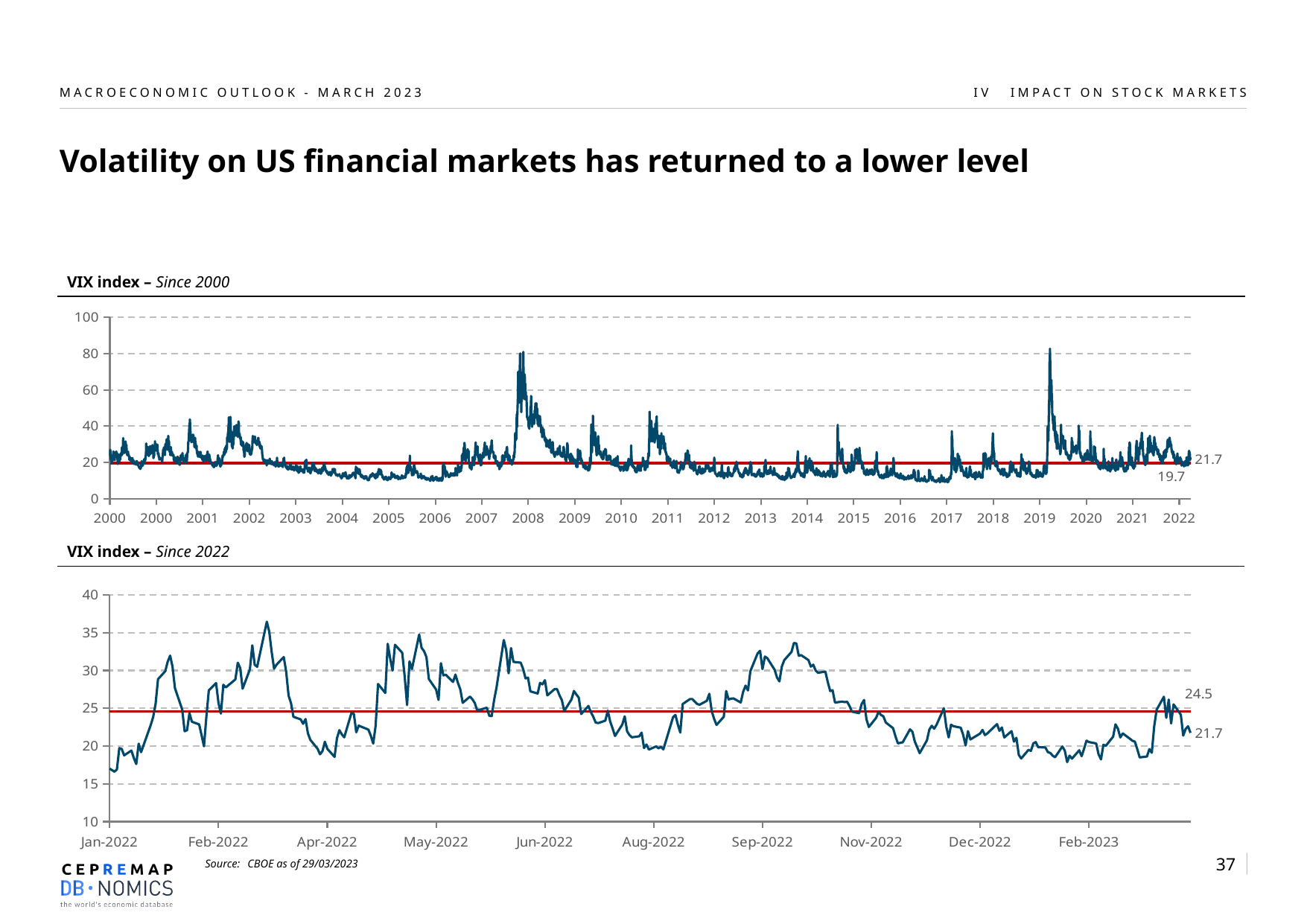
In the 'VIX index – Since 2022' chart, is the value at the start of Jan-2022 greater or less than 20? less What is the title of the slide? Volatility on US financial markets has returned to a lower level What kind of chart is the 'VIX index – Since 2022' chart? line chart In the 'VIX index – Since 2022' chart, what is the latest value labelled at the end of the line? 21.7 In the 'VIX index – Since 2000' chart, is the peak of the line around 2008 greater or less than 60? greater In the 'VIX index – Since 2000' chart, what is the latest value labelled at the end of the line? 21.7 What kind of chart is the 'VIX index – Since 2000' chart? line chart In the 'VIX index – Since 2022' chart, is the latest value (21.7) greater or less than the red line value (24.5)? less In the 'VIX index – Since 2000' chart, what value is labelled on the horizontal red line? 19.7 In the 'VIX index – Since 2022' chart, what value is labelled on the horizontal red line? 24.5 In the 'VIX index – Since 2000' chart, what is the difference between the latest value (21.7) and the red line value (19.7)? 2.0 In the 'VIX index – Since 2022' chart, what is the difference between the red line value (24.5) and the latest value (21.7)? 2.8